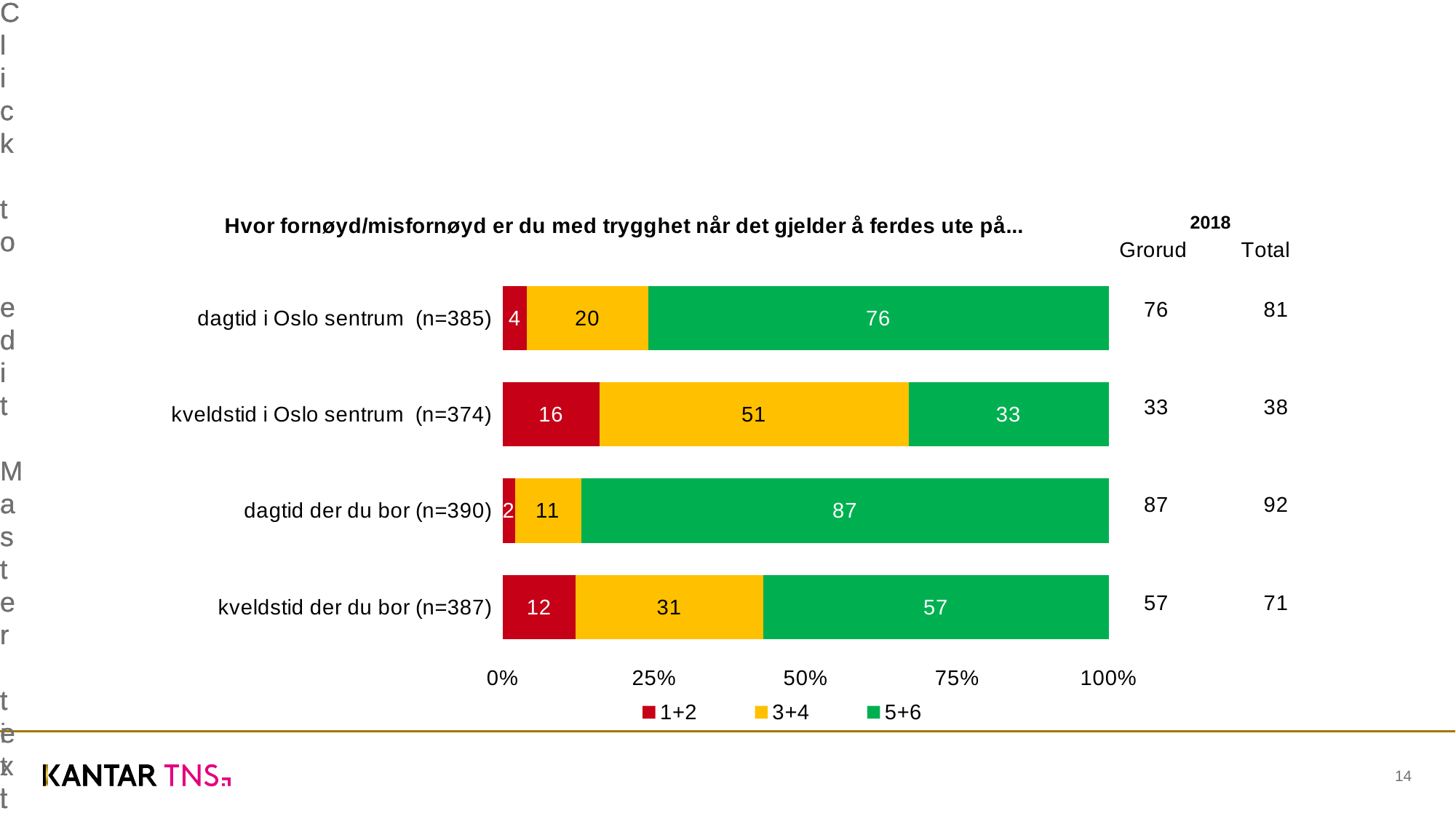
How many categories are shown in the chart? 4 What kind of chart is shown on the slide? Stacked bar chart Which is larger: the 3+4 value for "kveldstid i Oslo sentrum" or the 3+4 value for "kveldstid der du bor"? kveldstid i Oslo sentrum What is the value of the 5+6 segment for "dagtid i Oslo sentrum"? 76 What is the value of the 1+2 segment for "kveldstid der du bor"? 12 What is the difference between the 5+6 values for "dagtid der du bor" and "kveldstid der du bor"? 30 What is the total of the stacked bar for "kveldstid i Oslo sentrum"? 100 Which category has the lowest 1+2 value? dagtid der du bor Which category has the highest 5+6 value? dagtid der du bor What is the 2018 Total value shown next to "kveldstid der du bor"? 71 How many series does the legend list? 3 What is the value of the 3+4 segment for "kveldstid i Oslo sentrum"? 51